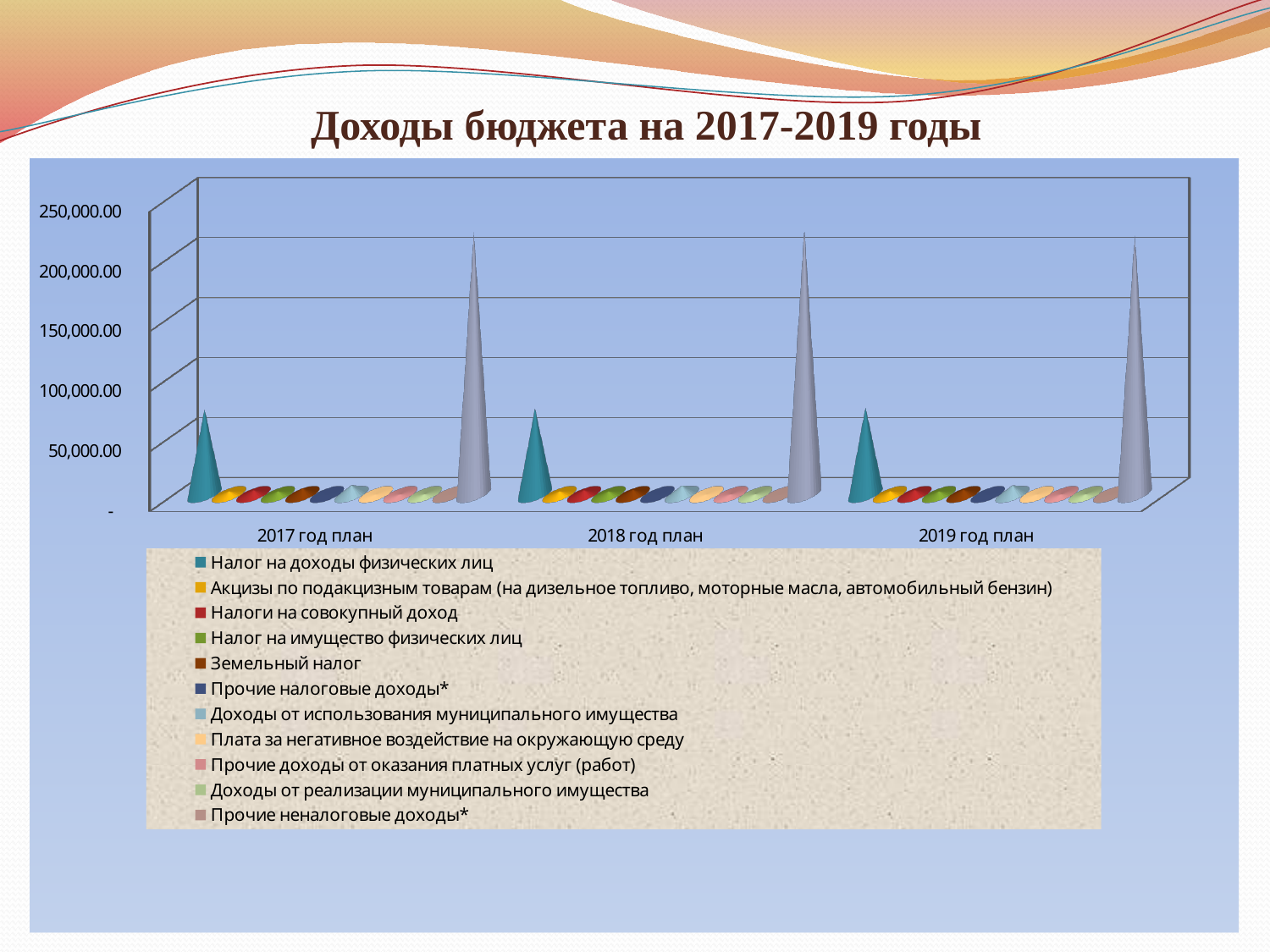
Is the tallest cone in the 2019 год план group greater or less than 150,000.00? greater What is the title of the slide containing the chart? Доходы бюджета на 2017-2019 годы Is the value for Налог на доходы физических лиц in 2017 год план greater or less than 50,000.00? greater Is the value for Налог на доходы физических лиц in 2018 год план greater or less than 100,000.00? less What is the label of the last category on the horizontal axis? 2019 год план What is the first entry listed in the chart legend? Налог на доходы физических лиц What kind of chart is shown on the slide? bar chart How many categories are shown on the horizontal axis of the chart? 3 How many series does the chart legend list? 11 In 2019 год план, which is larger: Налог на доходы физических лиц or Акцизы по подакцизным товарам (на дизельное топливо, моторные масла, автомобильный бензин)? Налог на доходы физических лиц In 2017 год план, which is larger: Налог на доходы физических лиц or Земельный налог? Налог на доходы физических лиц